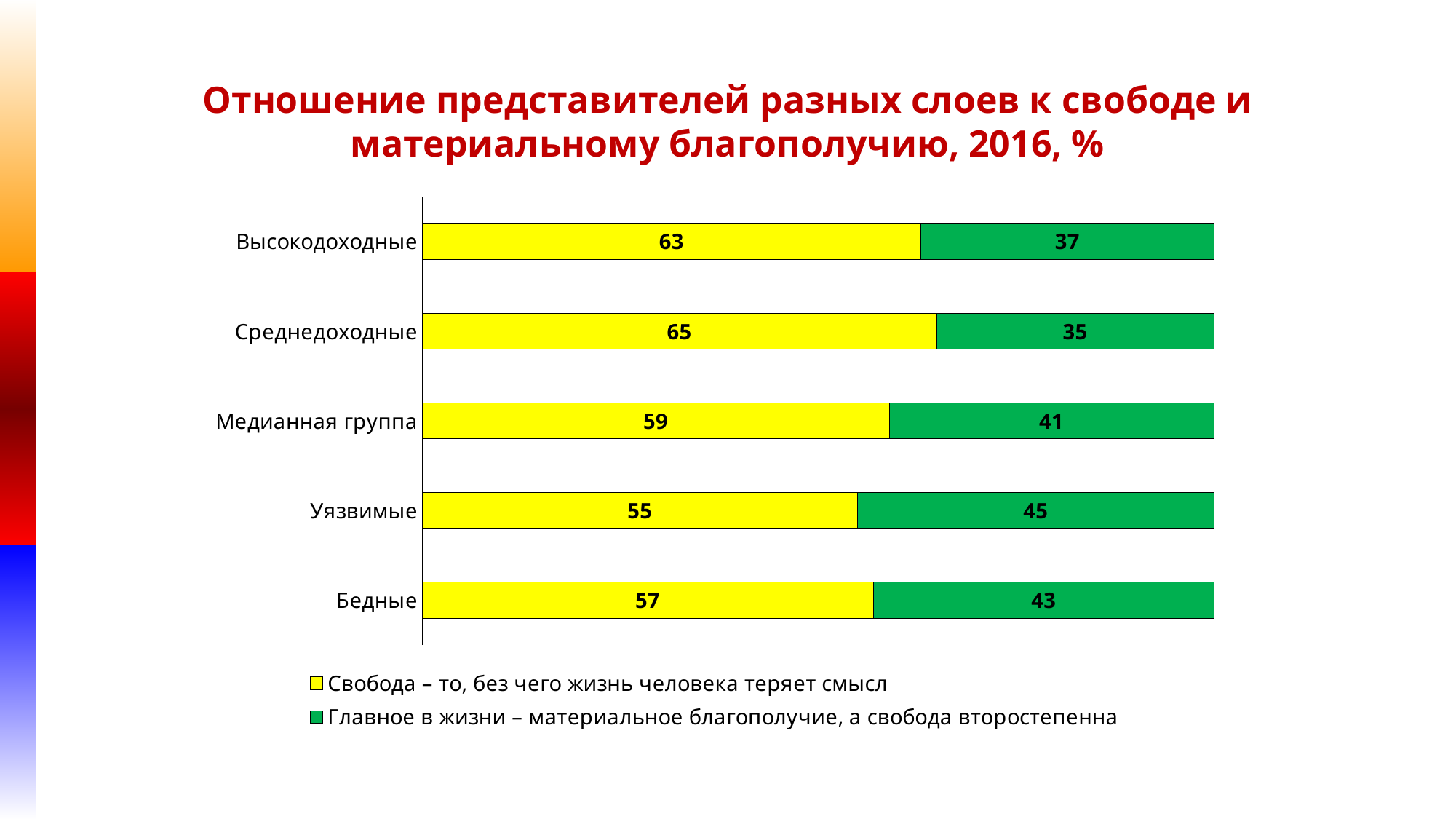
Which category has the highest value in the series 'Свобода – то, без чего жизнь человека теряет смысл'? Среднедоходные Which is larger: the 'Главное в жизни – материальное благополучие' value for Бедные or for Высокодоходные? Бедные How many categories are shown on the chart? 5 What is the value for Высокодоходные in the series 'Свобода – то, без чего жизнь человека теряет смысл'? 63 What is the value for Бедные in the series 'Свобода – то, без чего жизнь человека теряет смысл'? 57 What is the difference between the 'Свобода' value for Среднедоходные and for Медианная группа? 6 What is the total of the stacked bar for Медианная группа? 100 Which category has the highest value in the series 'Главное в жизни – материальное благополучие, а свобода второстепенна'? Уязвимые What kind of chart is shown on the slide? Stacked bar chart Which category has the lowest value in the series 'Свобода – то, без чего жизнь человека теряет смысл'? Уязвимые What is the value for Уязвимые in the series 'Главное в жизни – материальное благополучие, а свобода второстепенна'? 45 How many series does the legend list? 2